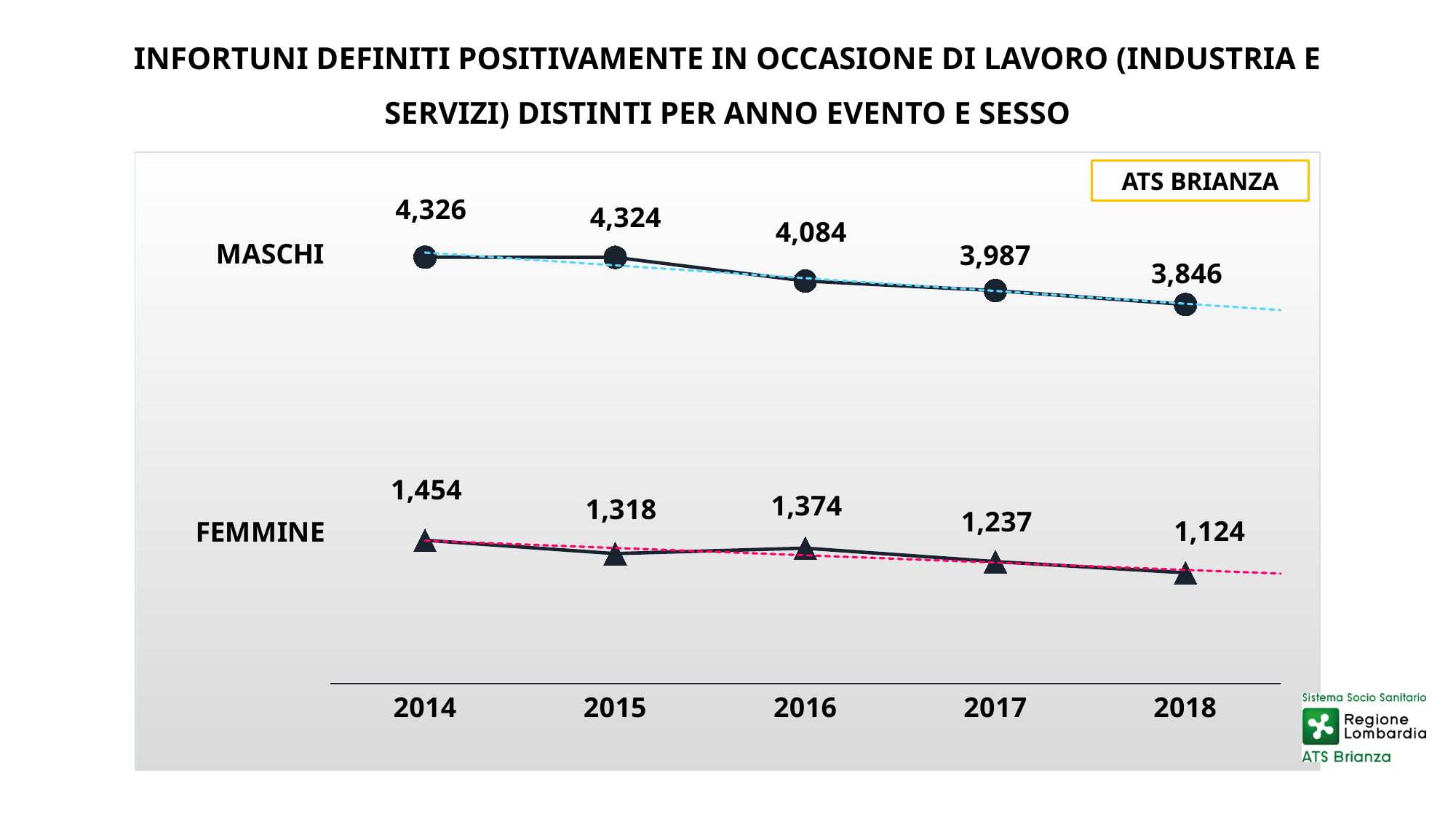
In which year is the FEMMINE value highest? 2014 What is the difference between the FEMMINE values in 2015 and 2016? 56 What is the value for FEMMINE in 2018? 1,124 Which is larger, the FEMMINE value in 2015 or in 2016? 2016 In which year is the MASCHI value lowest? 2018 What is the value for MASCHI in 2014? 4,326 What is the difference between the MASCHI values in 2014 and 2018? 480 What kind of chart is this? line chart How many years are shown on the x axis? 5 What is the value for MASCHI in 2018? 3,846 What is the value for FEMMINE in 2016? 1,374 Do the MASCHI values rise or fall from 2014 to 2018? fall